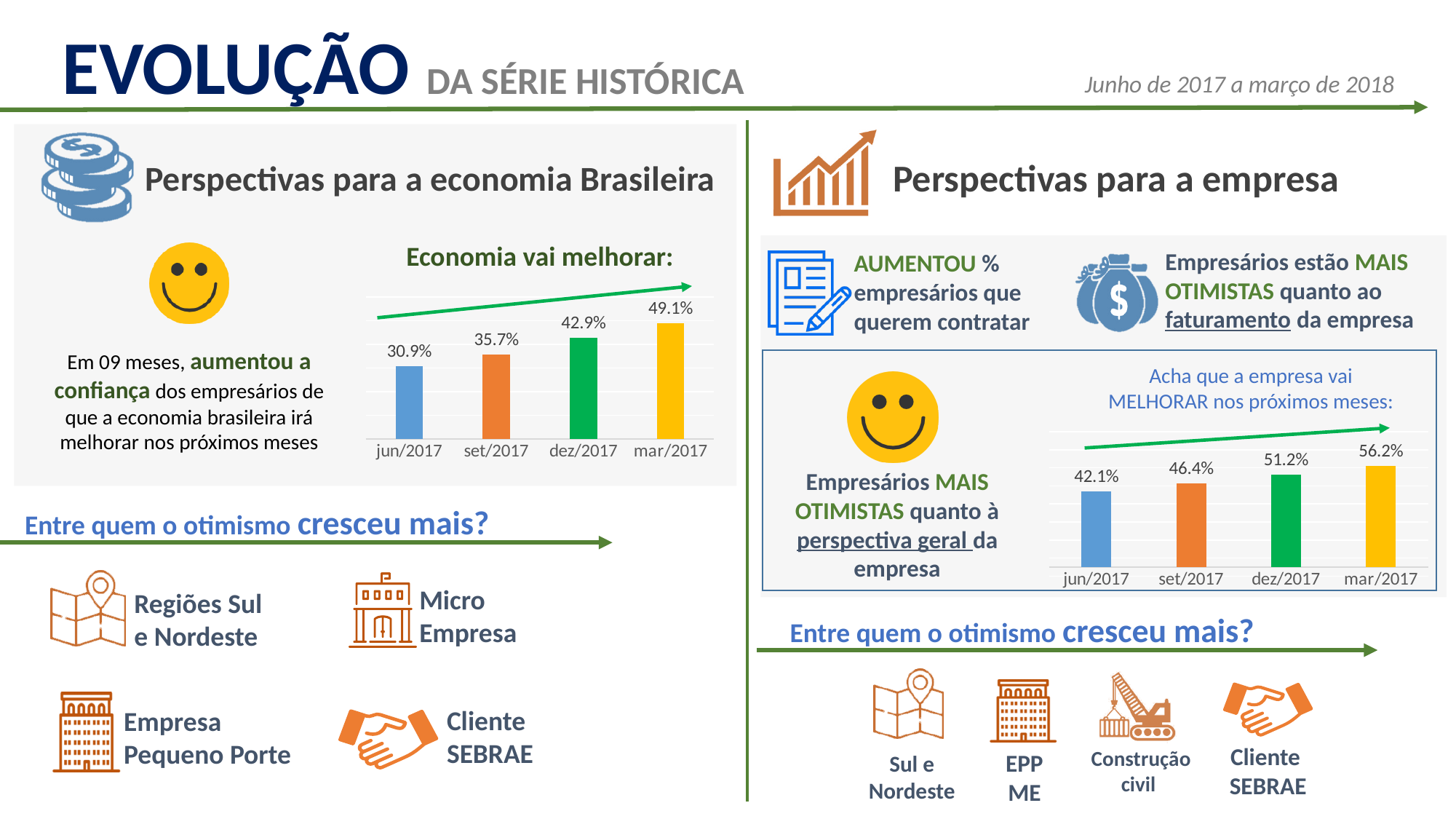
In the 'Acha que a empresa vai MELHORAR nos próximos meses' chart, what is the difference between the dez/2017 and set/2017 values? 4.8% In the 'Economia vai melhorar' chart, do the values rise or fall from jun/2017 to mar/2017? rise In the 'Economia vai melhorar' chart, what is the difference between the mar/2017 and jun/2017 values? 18.2% In the 'Economia vai melhorar' chart, what is the value for dez/2017? 42.9% In the 'Acha que a empresa vai MELHORAR nos próximos meses' chart, what is the value for set/2017? 46.4% In the 'Economia vai melhorar' chart, how many bars are plotted? 4 In the 'Acha que a empresa vai MELHORAR nos próximos meses' chart, what is the value for mar/2017? 56.2% Which is larger: the dez/2017 value in the 'Economia vai melhorar' chart or the dez/2017 value in the 'Acha que a empresa vai MELHORAR' chart? Acha que a empresa vai MELHORAR (51.2%) In the 'Economia vai melhorar' chart, which category has the highest value? mar/2017 In the 'Economia vai melhorar' chart, what is the value for jun/2017? 30.9% What type of chart is the 'Acha que a empresa vai MELHORAR nos próximos meses' chart? bar chart In the 'Acha que a empresa vai MELHORAR nos próximos meses' chart, which category has the lowest value? jun/2017